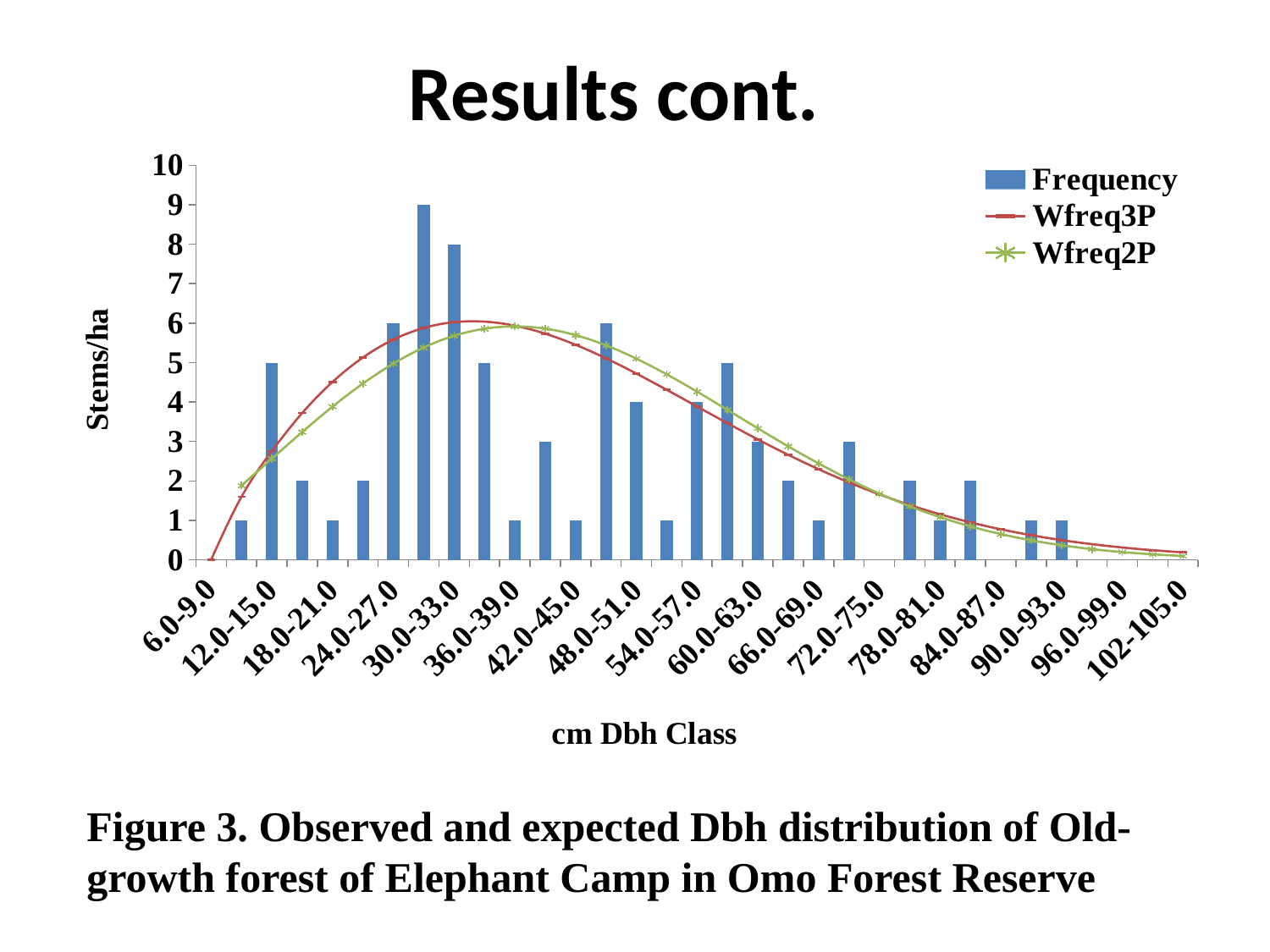
What is the Frequency value for the 18.0-21.0 Dbh class? 1 What are the three series named in the legend? Frequency, Wfreq3P, Wfreq2P What is the Frequency value for the 30.0-33.0 Dbh class? 8 What is the highest Frequency value reached by any bar? 9 What is the label of the y axis? Stems/ha Is the Wfreq2P value at the 90.0-93.0 class greater or less than 1? less What is the Frequency value for the 12.0-15.0 Dbh class? 5 Which has the larger Frequency, the 12.0-15.0 class or the 18.0-21.0 class? 12.0-15.0 Is the Wfreq3P value at the 30.0-33.0 class greater or less than 5? greater What is the difference in Frequency between the 30.0-33.0 class and the 12.0-15.0 class? 3 How many series does the legend list? 3 What kind of chart is shown on the slide? Bar chart with line series